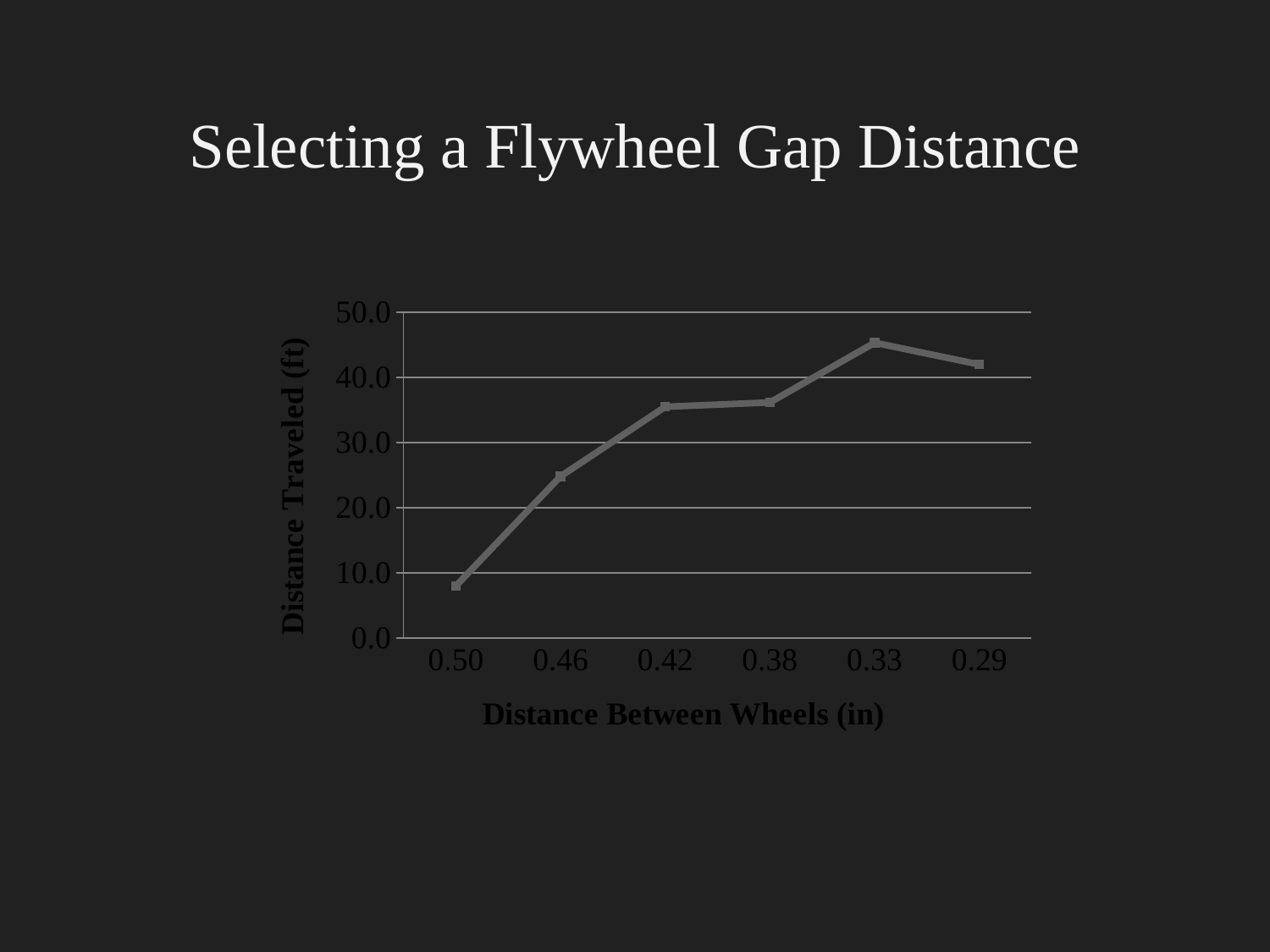
Is the distance traveled at 0.38 in greater or less than 40.0 ft? less Which has a larger distance traveled: 0.46 in or 0.42 in? 0.42 What is the title of the y axis? Distance Traveled (ft) How many data points are plotted on the chart? 6 What kind of chart is shown on the slide? line chart At which distance between wheels is the distance traveled lowest? 0.50 Does the distance traveled generally rise or fall from 0.50 in to 0.33 in along the x axis? rise At which distance between wheels is the distance traveled highest? 0.33 Is the distance traveled at 0.50 in greater or less than 10.0 ft? less Is the distance traveled at 0.46 in greater or less than 20.0 ft? greater